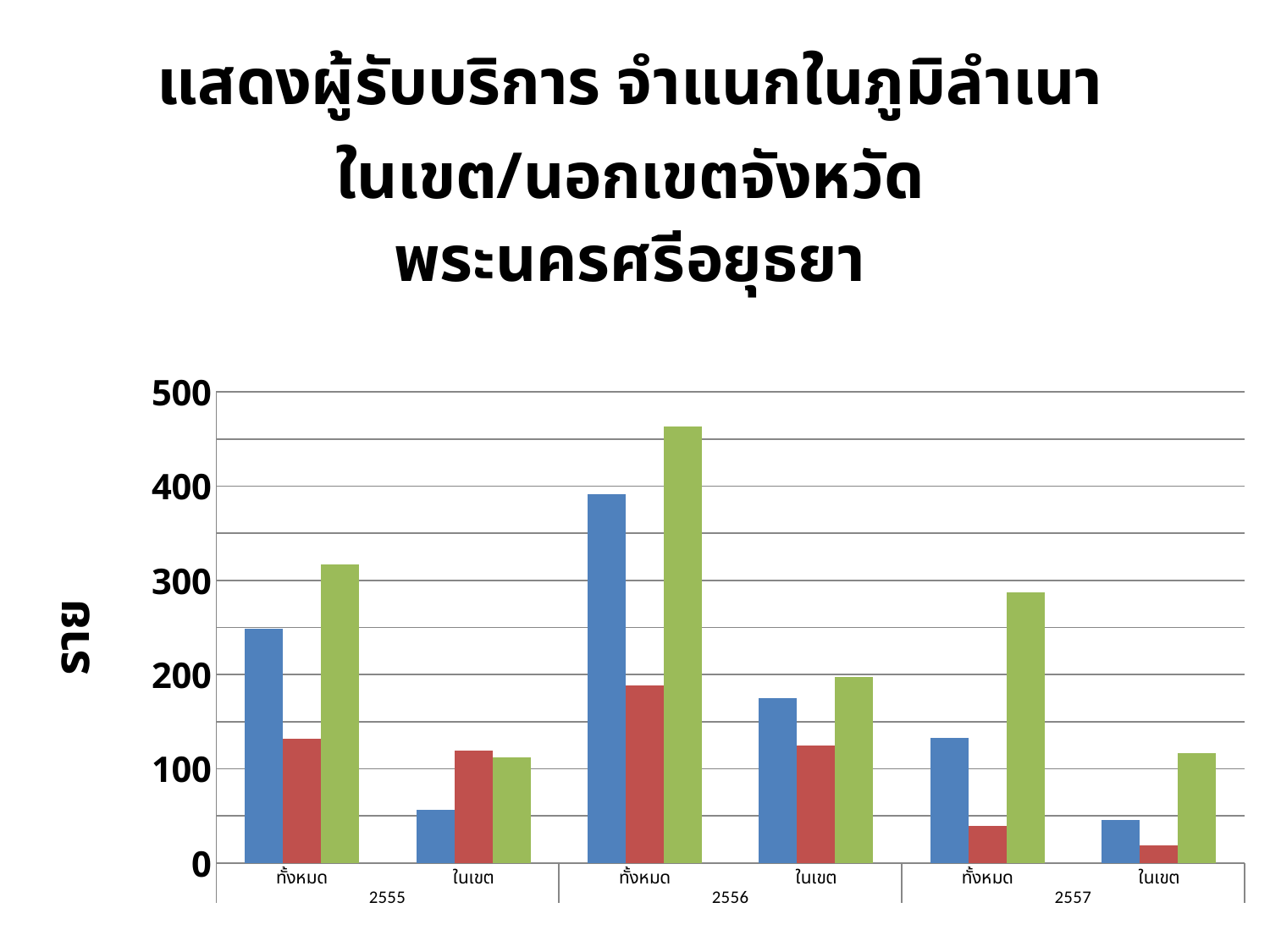
In which category group does the tallest bar of the chart appear? ทั้งหมด 2556 Is the value of the green bar for ทั้งหมด in 2555 greater or less than 300? greater Which years are shown along the x axis of the chart? 2555, 2556, 2557 Does the blue bar for ทั้งหมด rise or fall from 2556 to 2557? fall Is the value of the green bar for ทั้งหมด in 2556 greater or less than 400? greater Is the value of the blue bar for ในเขต in 2555 greater or less than 100? less Which is larger: the blue bar for ทั้งหมด in 2555 or the blue bar for ทั้งหมด in 2557? ทั้งหมด 2555 How many category groups are shown along the x axis of the chart? 6 What kind of chart is shown on the slide? bar chart What is the label on the vertical axis of the chart? ราย How many bars are plotted in each category group of the chart? 3